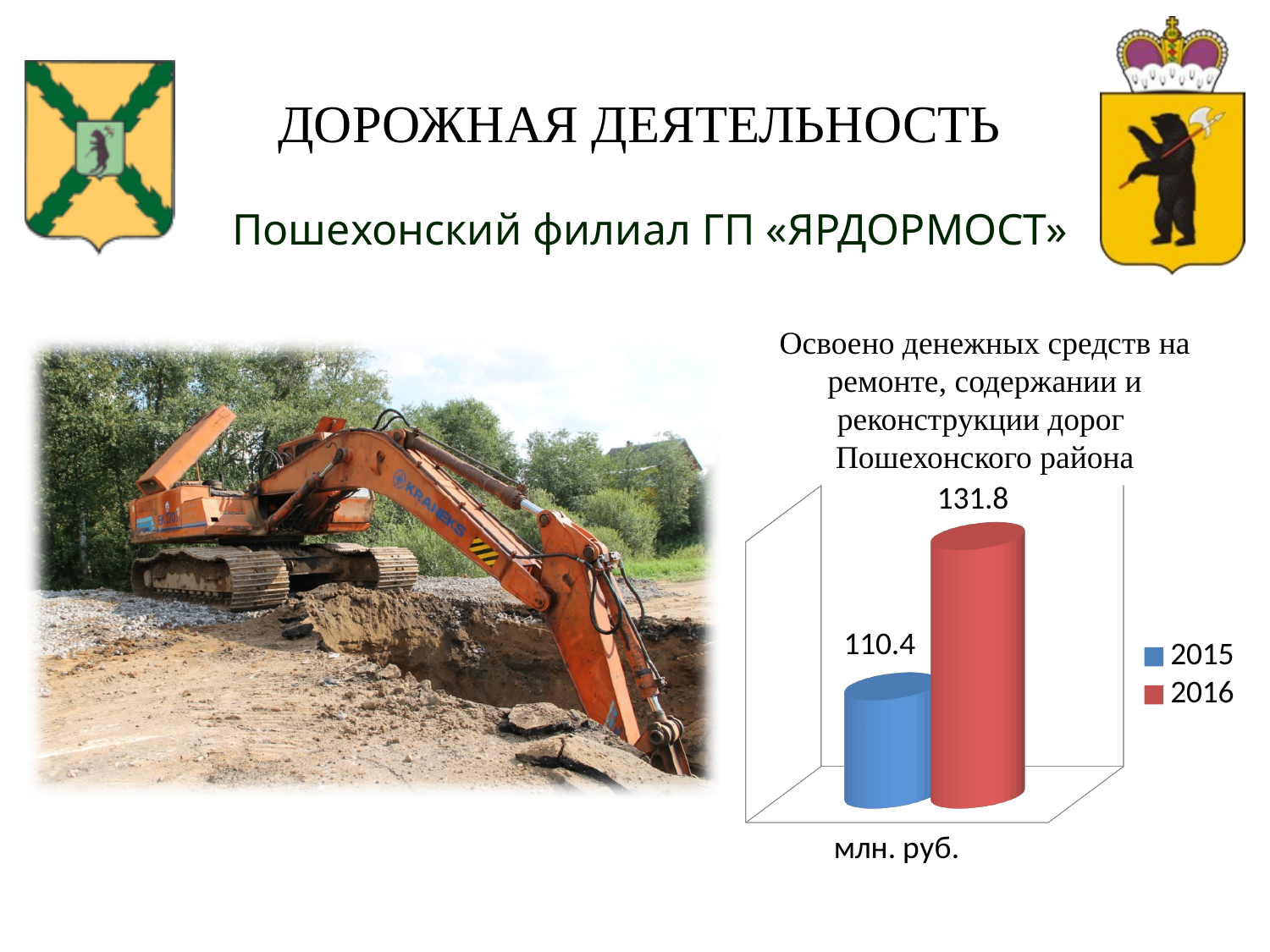
What unit is indicated below the chart? млн. руб. What kind of chart is shown on the slide? bar chart Do the values rise or fall from 2015 to 2016? rise How many series does the chart legend list? 2 Is the value for 2016 larger or smaller than the value for 2015? larger Which colour represents 2016 in the chart legend? red Which year has the lower value in the chart? 2015 What value is shown for 2016 in the chart? 131.8 What is the difference between the 2016 and 2015 values in the chart? 21.4 How many bars are plotted in the chart? 2 Which year has the higher value in the chart? 2016 What value is shown for 2015 in the chart? 110.4